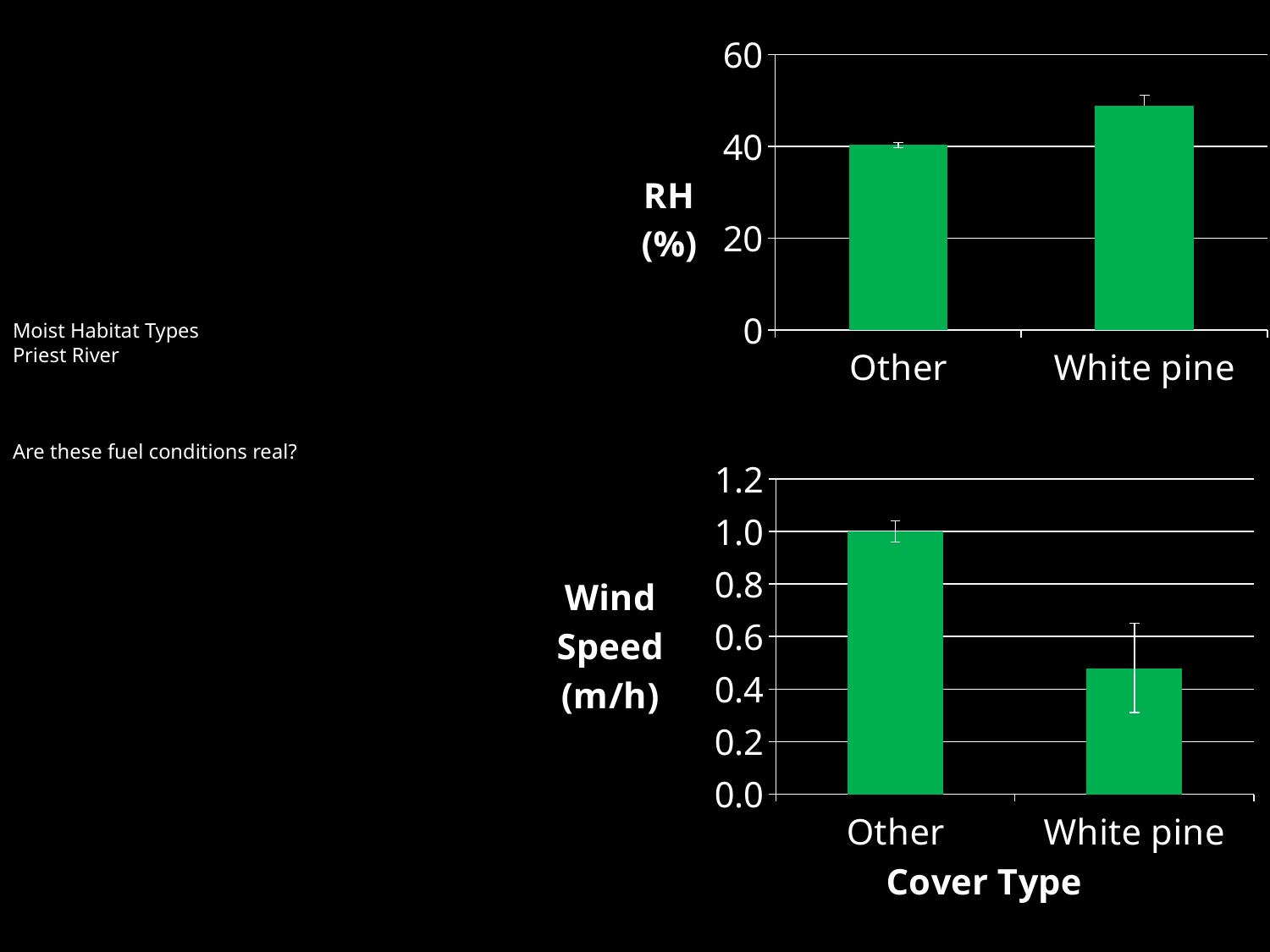
In the bottom chart (Wind Speed), what is the wind speed for Other? 1.0 In the bottom chart (Wind Speed), is the value for White pine greater or less than 0.6? less How many cover type categories are shown in the top chart (RH %)? 2 In the top chart (RH %), is the value for White pine greater or less than 40? greater In the bottom chart (Wind Speed), is the value for Other larger or smaller than the value for White pine? larger What is the x-axis title of the bottom chart? Cover Type What is the y-axis label of the top chart? RH (%) In the bottom chart (Wind Speed), is the value for White pine greater or less than 0.4? greater In the bottom chart (Wind Speed), which cover type has the lower wind speed? White pine What kind of chart is the bottom chart (Wind Speed)? bar chart In the top chart (RH %), which cover type has the higher relative humidity? White pine